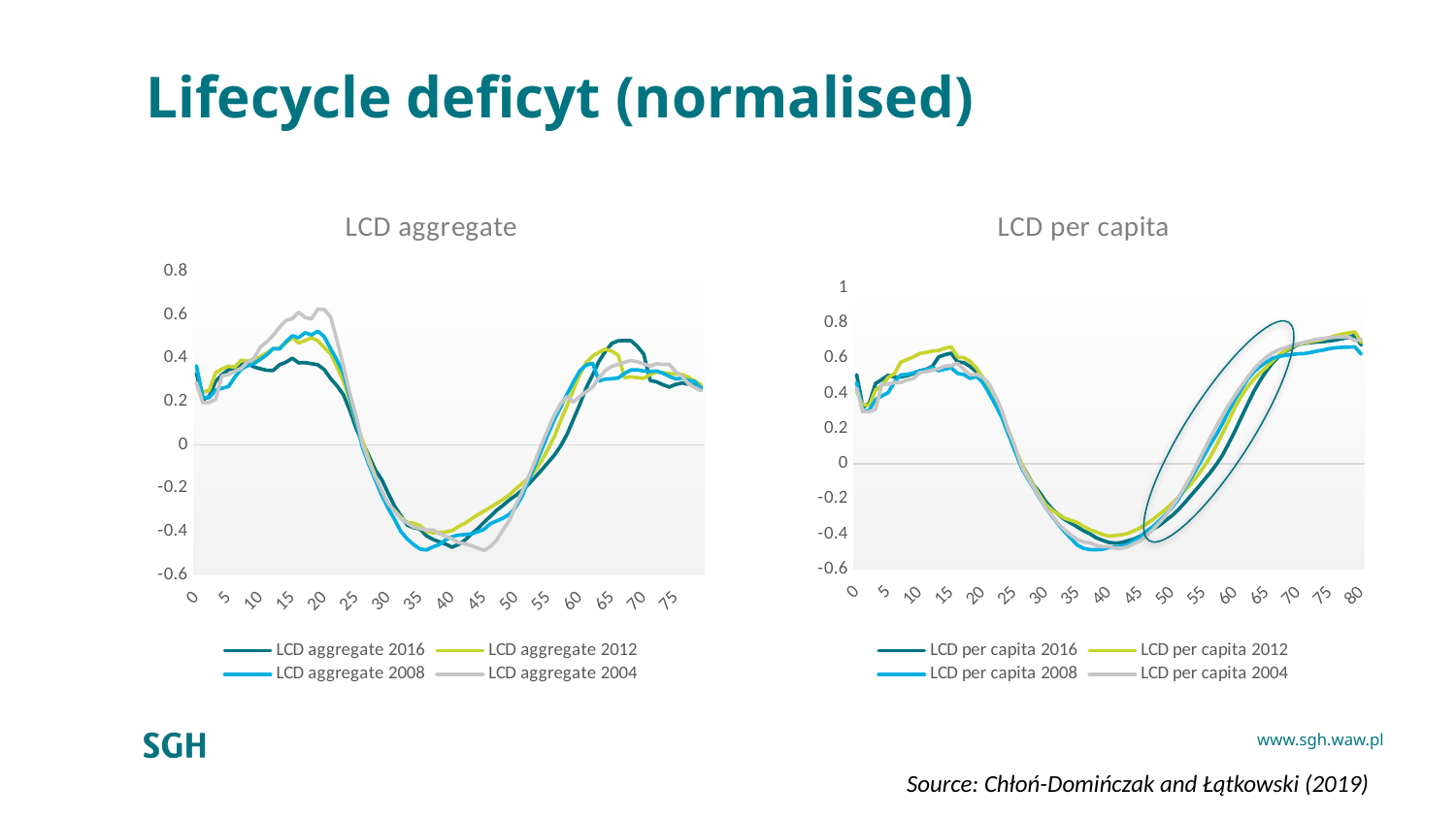
In the LCD aggregate chart, is the value for LCD aggregate 2016 at age 40 greater or less than 0? less In the LCD aggregate chart, do the values rise or fall between age 20 and age 35? fall In the LCD per capita chart, is the value for LCD per capita 2008 at age 40 greater or less than -0.2? less How many charts are shown on the slide? 2 In the LCD aggregate chart, which series reaches the highest peak value? LCD aggregate 2004 In the LCD per capita chart, do the values rise or fall between age 45 and age 65? rise In the LCD per capita chart, is the value for LCD per capita 2012 at age 75 greater or less than 0.4? greater What kind of chart is the LCD aggregate chart? line chart How many series does the legend of the LCD per capita chart list? 4 What is the title of the chart on the right side of the slide? LCD per capita In the LCD aggregate chart, at age 20, which series has the higher value: LCD aggregate 2004 or LCD aggregate 2016? LCD aggregate 2004